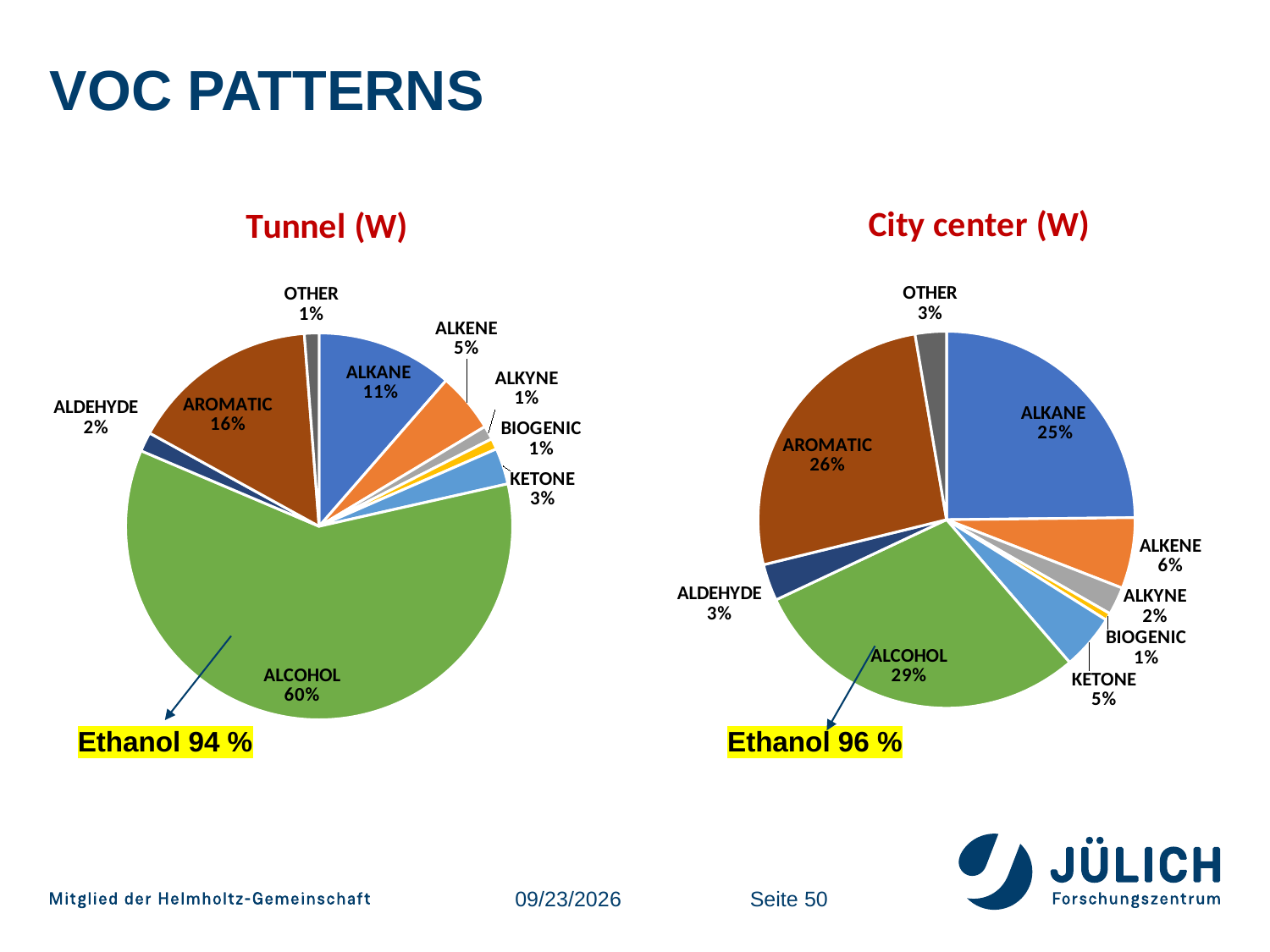
In the City center (W) chart, what share does KETONE have? 5% In the City center (W) chart, what share does AROMATIC have? 26% How many categories are shown in the Tunnel (W) pie chart? 9 In the Tunnel (W) chart, what is the difference between the ALCOHOL and AROMATIC shares? 44% What kind of chart is the City center (W) chart? Pie chart In the City center (W) chart, which is larger, ALKANE or ALKENE? ALKANE In the Tunnel (W) chart, what share does ALCOHOL have? 60% In the Tunnel (W) chart, what share does ALKANE have? 11% In the City center (W) chart, which category has the largest share? ALCOHOL What is the title of the chart on the left of the slide? Tunnel (W) What is the difference between the ALKANE shares in the City center (W) and Tunnel (W) charts? 14% In the Tunnel (W) chart, which category has the largest share? ALCOHOL